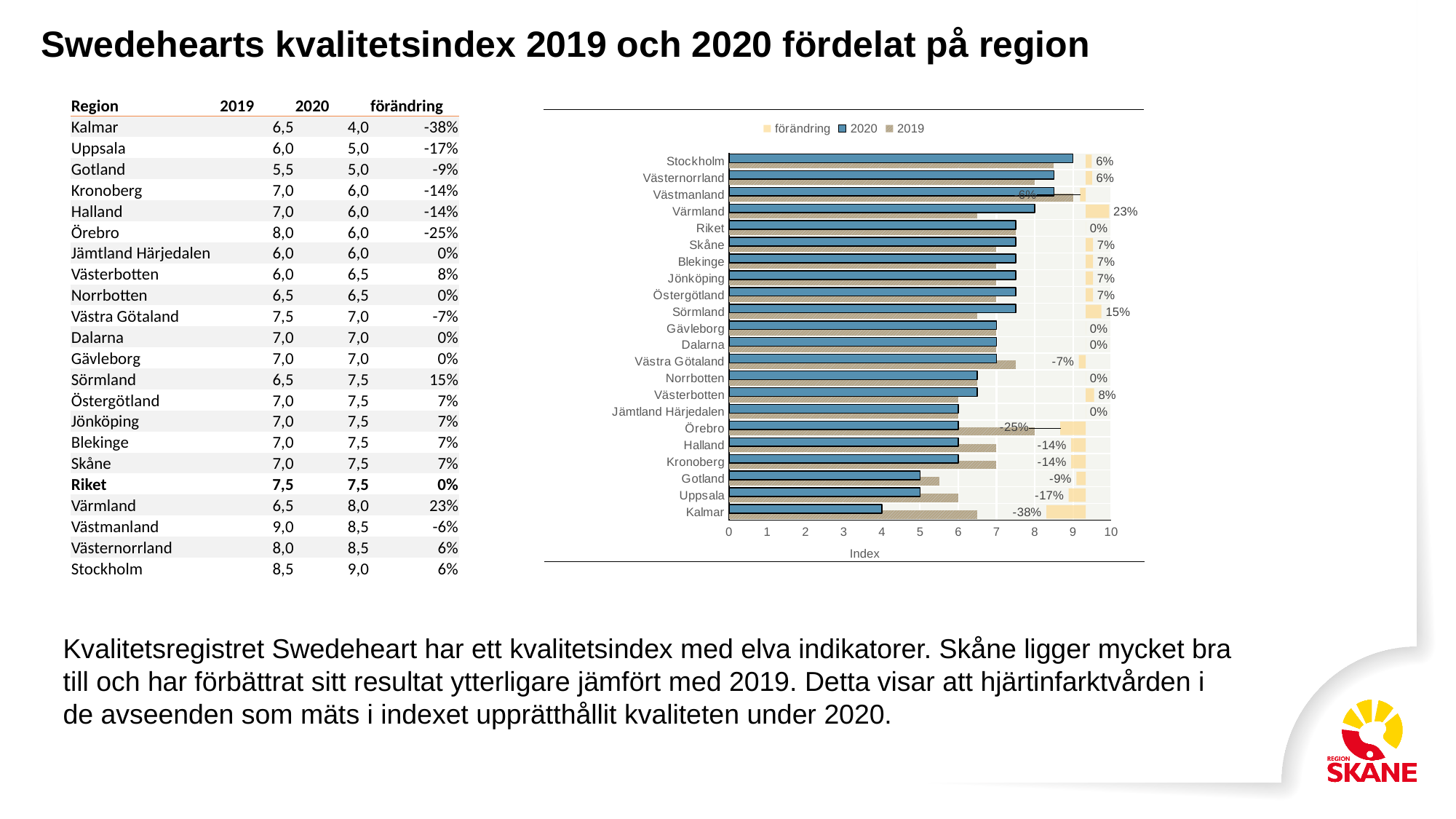
What is the difference between the förändring values for Värmland and Sörmland? 8 percentage points What is the förändring value shown for Värmland? 23% What is the title of the horizontal axis of the chart? Index How many series does the chart legend list? 3 Which region has the lowest 2020 index bar? Kalmar Which region has the lowest förändring value? Kalmar How many regions (categories) are plotted on the chart? 22 Which region has the highest förändring value? Värmland Which region has the highest 2020 index bar? Stockholm What is the förändring value shown for Kalmar? -38% Is the 2019 index value for Västmanland greater or less than 8? greater What kind of chart is shown on the slide? bar chart